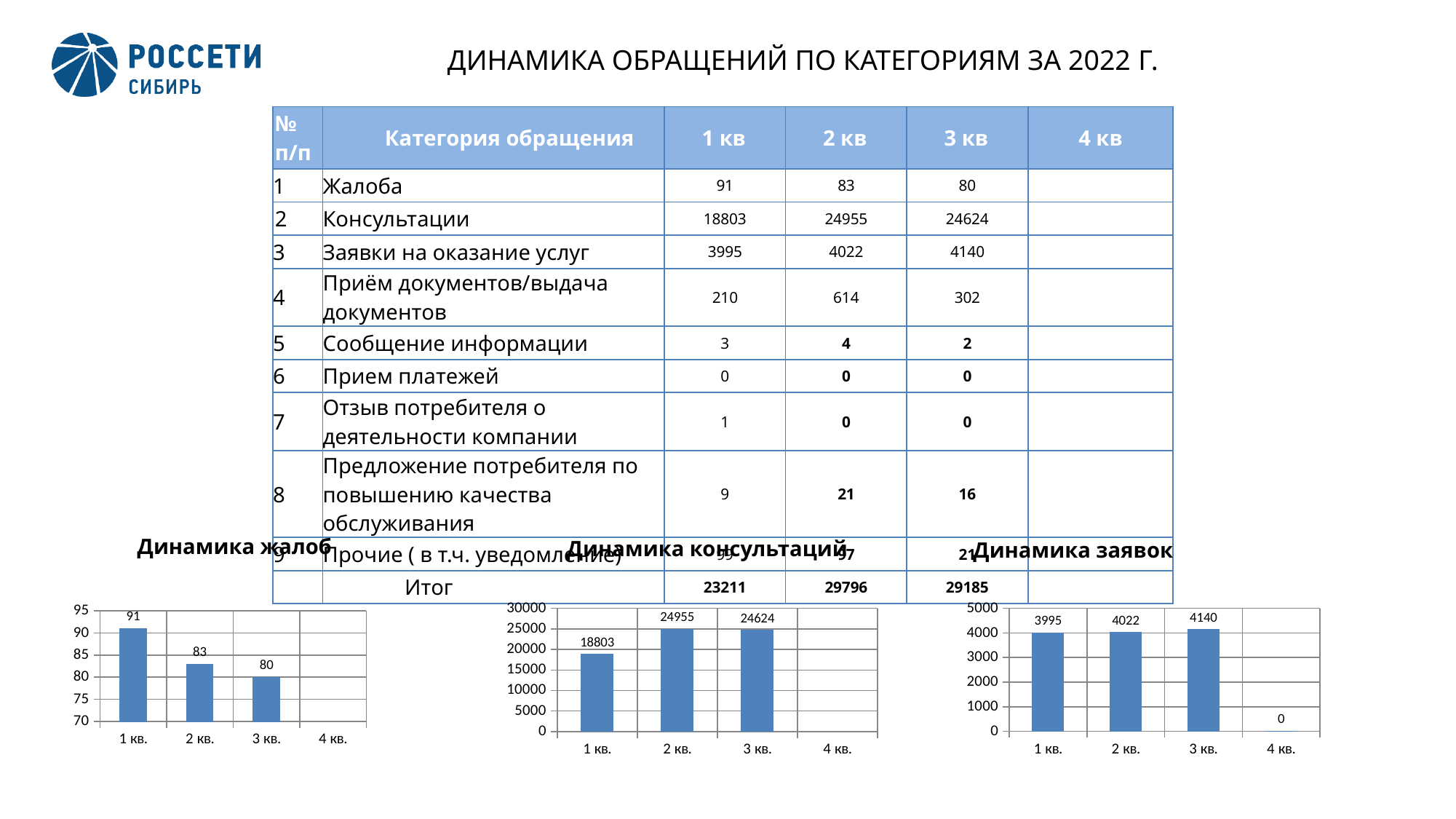
In the chart titled "Динамика заявок", what is the value for 3 кв.? 4140 In the chart titled "Динамика консультаций", what is the difference between the values for 2 кв. and 1 кв.? 6152 What kind of chart is the chart titled "Динамика заявок"? bar chart In the chart titled "Динамика жалоб", what is the difference between the values for 1 кв. and 3 кв.? 11 In the chart titled "Динамика консультаций", which quarter has the highest value? 2 кв. In the chart titled "Динамика заявок", which is larger, the value for 2 кв. or the value for 3 кв.? 3 кв. In the chart titled "Динамика консультаций", what is the value for 2 кв.? 24955 In the chart titled "Динамика жалоб", which quarter has the lowest labelled value? 3 кв. In the chart titled "Динамика консультаций", is the value for 1 кв. greater or less than 20000? less In the chart titled "Динамика заявок", what is the value for 4 кв.? 0 In the chart titled "Динамика жалоб", do the values rise or fall from 1 кв. to 3 кв.? fall In the chart titled "Динамика жалоб", what is the value for 1 кв.? 91